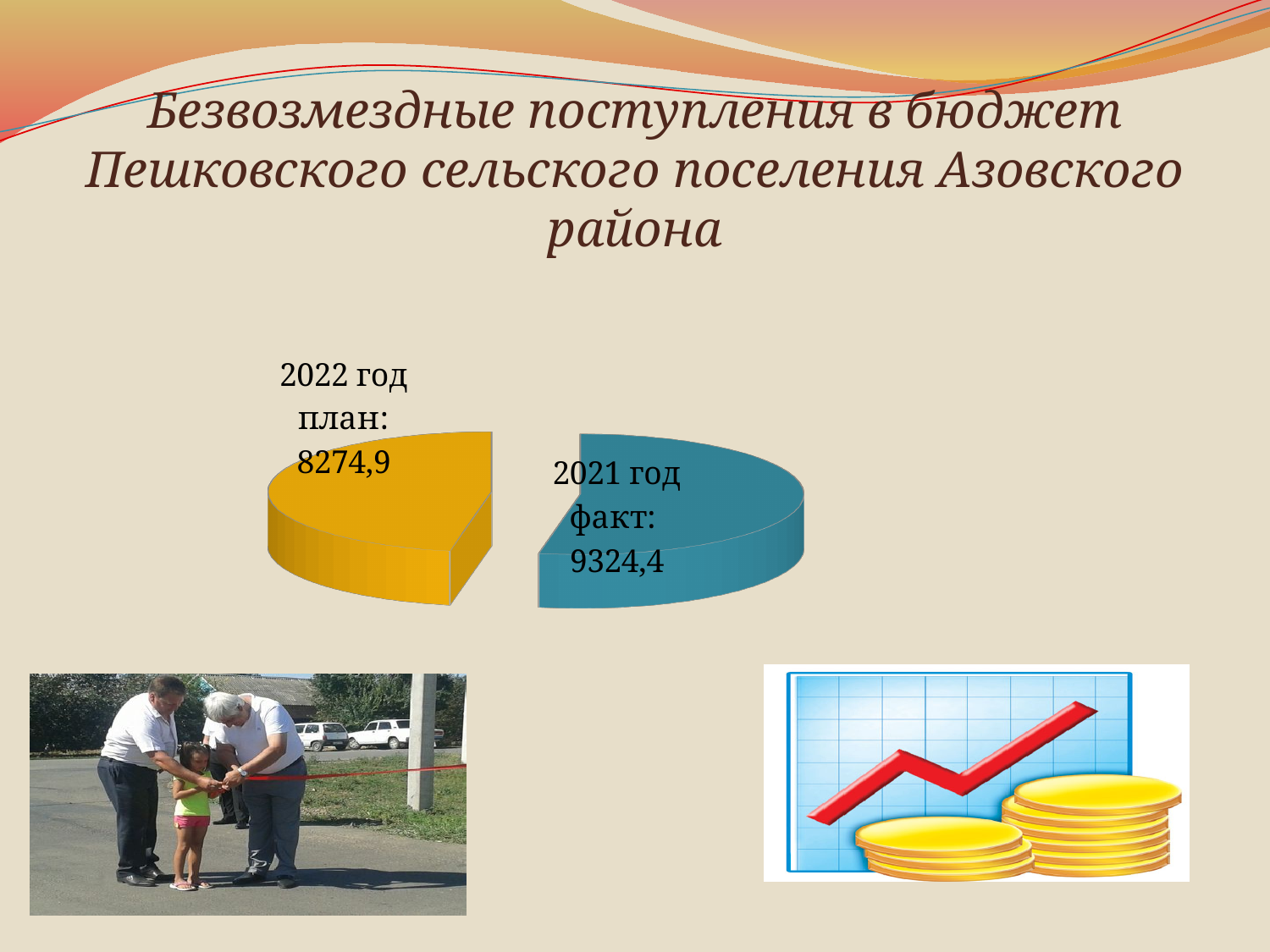
What kind of chart is shown on the slide? Pie chart What colour is the slice for 2022 год план? Yellow What is the total of the two values shown in the pie chart? 17599,3 What is the value shown for 2021 год факт? 9324,4 How many slices does the pie chart have? 2 What is the value shown for 2022 год план? 8274,9 What is the difference between the 2021 год факт value and the 2022 год план value? 1049,5 Which is larger: the 2021 год факт value or the 2022 год план value? 2021 год факт What colour is the slice for 2021 год факт? Blue Which slice of the pie chart has the smaller value? 2022 год план Which slice of the pie chart has the larger value? 2021 год факт